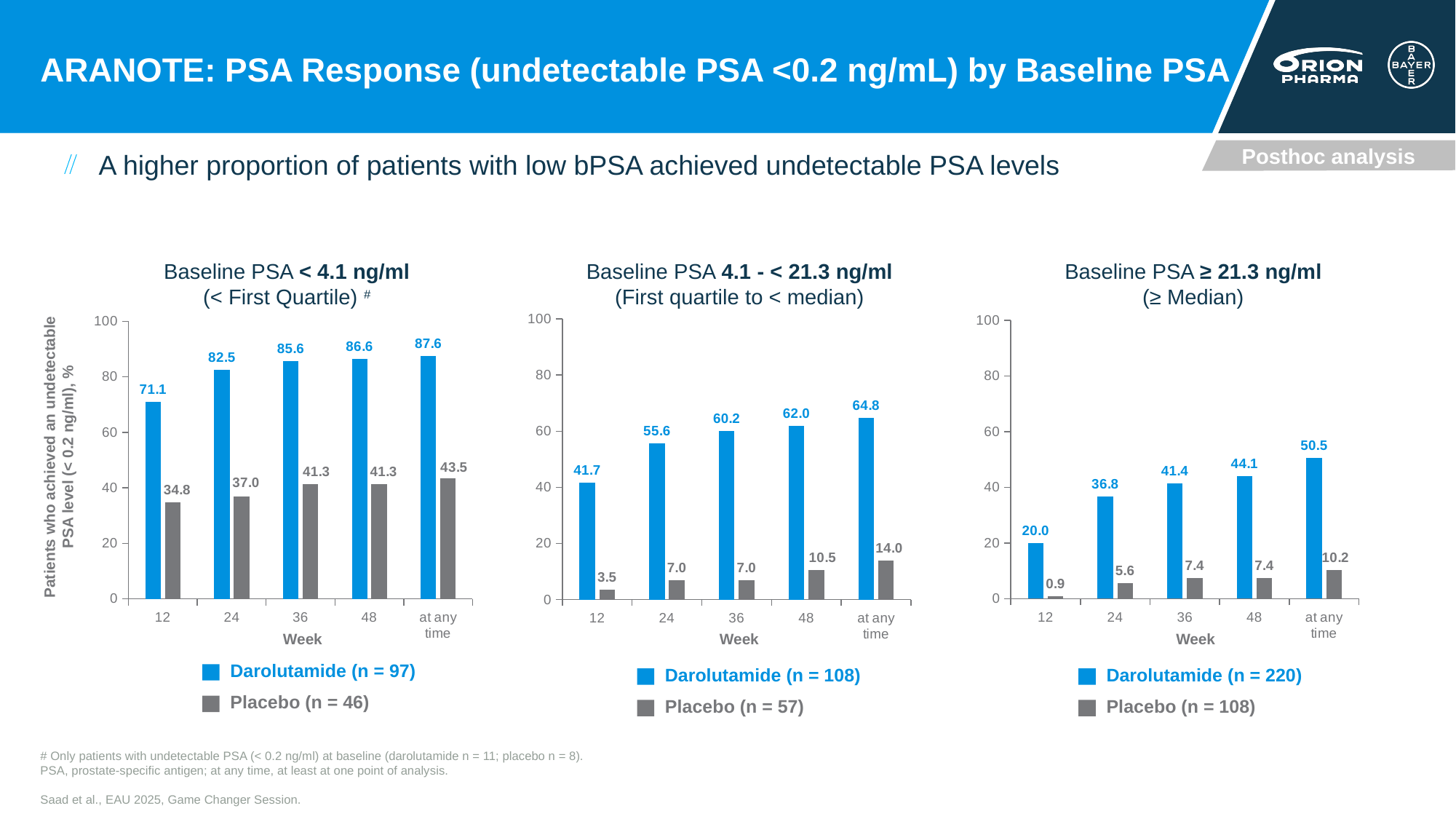
What kind of chart is the 'Baseline PSA 4.1 - < 21.3 ng/ml' chart? bar chart In the 'Baseline PSA < 4.1 ng/ml' chart, what is the value for Placebo at any time? 43.5 In the 'Baseline PSA < 4.1 ng/ml' chart, what is the value for Darolutamide at week 12? 71.1 How many series does the legend of the 'Baseline PSA ≥ 21.3 ng/ml' chart list? 2 In the 'Baseline PSA ≥ 21.3 ng/ml' chart, what is the difference between the Darolutamide values at week 24 and week 12? 16.8 In the 'Baseline PSA < 4.1 ng/ml' chart, do the Darolutamide values rise or fall from week 12 to at any time? rise In the 'Baseline PSA ≥ 21.3 ng/ml' chart, at which week is the Placebo value lowest? 12 In the 'Baseline PSA < 4.1 ng/ml' chart, what is the difference between Darolutamide and Placebo at week 48? 45.3 In the 'Baseline PSA 4.1 - < 21.3 ng/ml' chart, which is larger: Darolutamide at week 12 or Placebo at any time? Darolutamide at week 12 In the 'Baseline PSA 4.1 - < 21.3 ng/ml' chart, at which time point is the Darolutamide value highest? at any time In the 'Baseline PSA ≥ 21.3 ng/ml' chart, what is the value for Darolutamide at any time? 50.5 In the 'Baseline PSA 4.1 - < 21.3 ng/ml' chart, what is the value for Placebo at week 12? 3.5